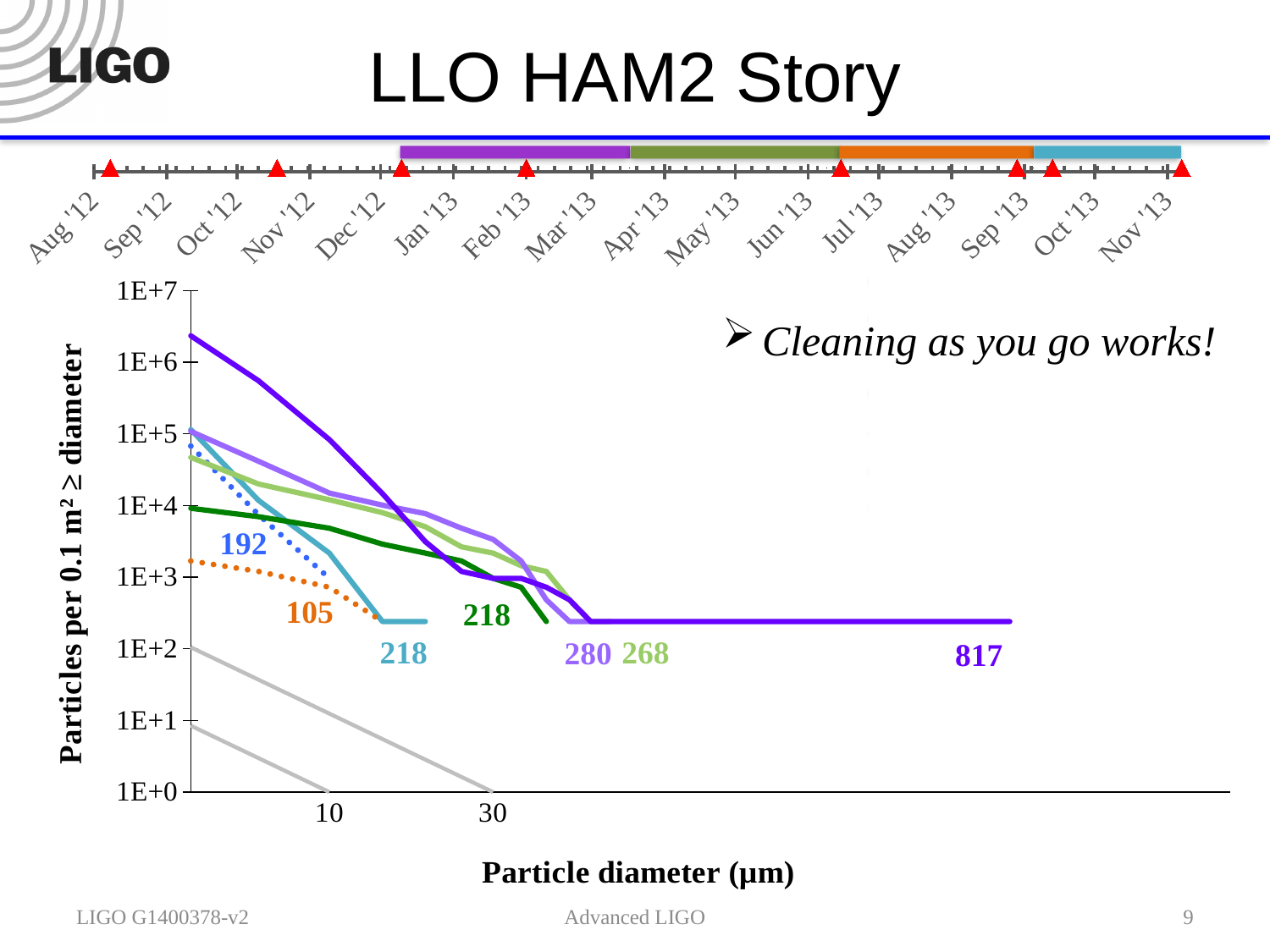
Do the curves rise or fall as particle diameter increases? fall Is the flat right-hand portion of the curve labelled 817 greater or less than 1E+2? greater What is the label of the y axis of the chart? Particles per 0.1 m² ≥ diameter Which labelled curve has the highest value at the smallest particle diameter? 817 What kind of chart is shown on the slide? line chart Which labelled curve extends furthest to the right along the particle diameter axis? 817 Is the value of the curve labelled 105 at the smallest particle diameter greater or less than 1E+4? less Which labelled curve has the lowest value at the smallest particle diameter? 105 Is the value of the curve labelled 817 at the smallest particle diameter greater or less than 1E+6? greater What is the highest tick value shown on the y axis? 1E+7 What is the label of the x axis of the chart? Particle diameter (µm) How many numbered curve labels are printed on the chart? 7